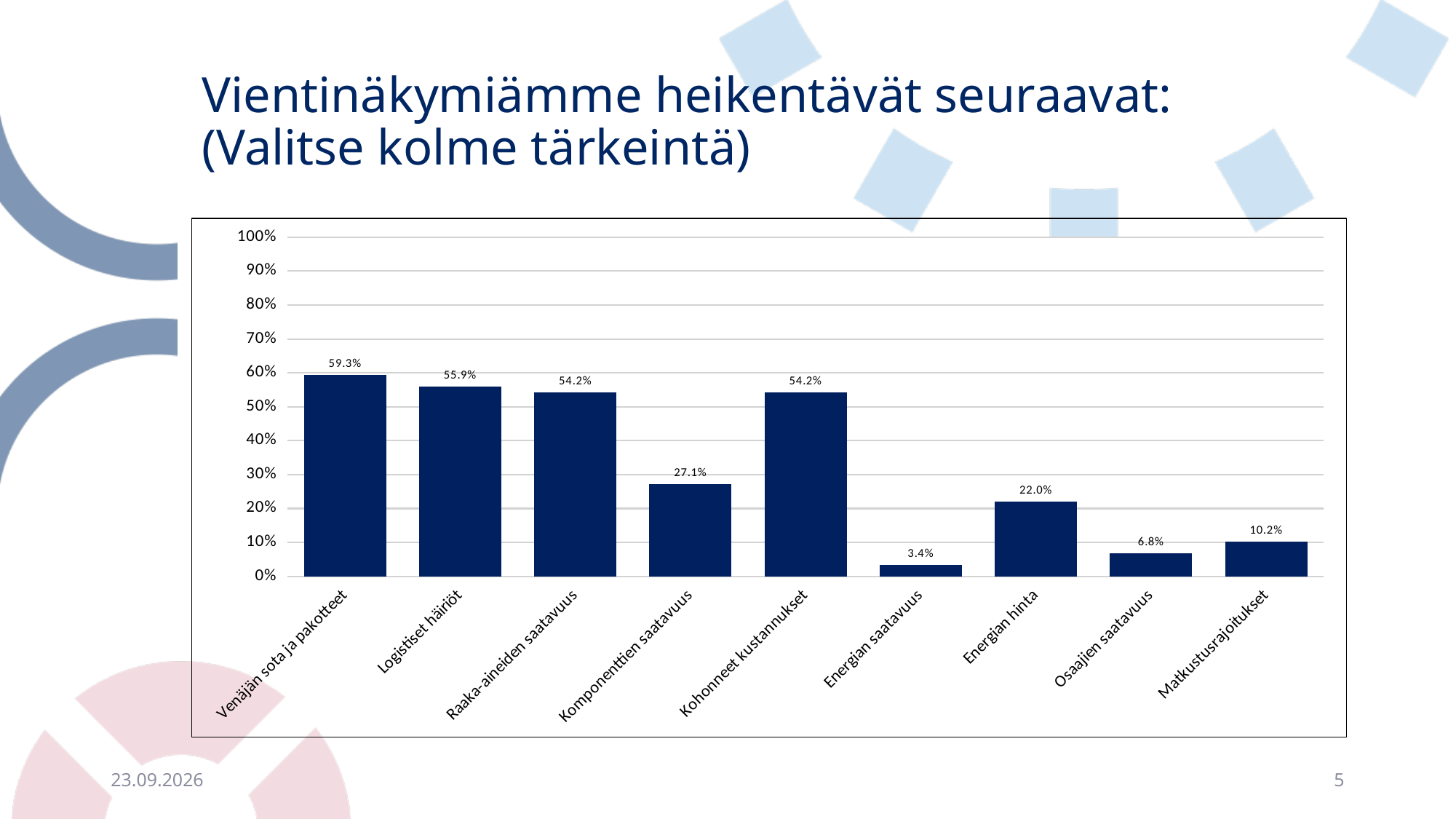
What is the value for Energian hinta? 22.0% Is the value for Kohonneet kustannukset greater or less than 50%? greater What is the value for Komponenttien saatavuus? 27.1% Which category has the highest value? Venäjän sota ja pakotteet What is the highest value shown on the vertical axis? 100% How many categories are shown on the x axis? 9 Which category has the lowest value? Energian saatavuus What is the difference between the values for Logistiset häiriöt and Energian hinta? 33.9% What is the value for Venäjän sota ja pakotteet? 59.3% What kind of chart is shown on the slide? Bar chart What is the value for Matkustusrajoitukset? 10.2% Which is larger, the value for Osaajien saatavuus or the value for Matkustusrajoitukset? Matkustusrajoitukset